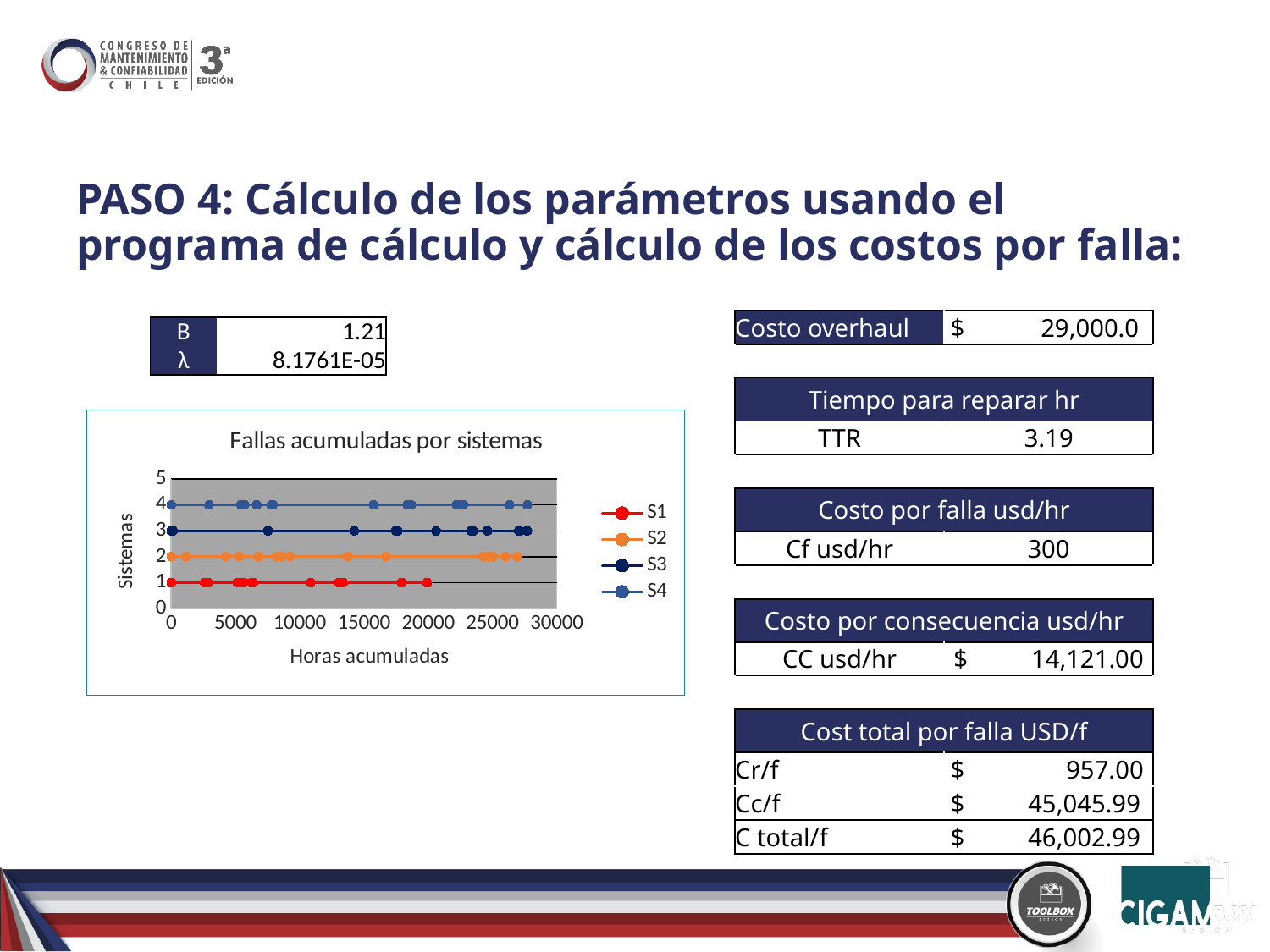
What is the title of the chart on the slide? Fallas acumuladas por sistemas Which series plots at the highest value on the Sistemas axis? S4 Which series lies higher on the Sistemas axis, S2 or S3? S3 What is the difference between the Sistemas value of series S4 and that of series S1? 3 What kind of chart is shown on the slide? line chart What are the series names listed in the chart legend? S1, S2, S3, S4 Which series plots at the lowest value on the Sistemas axis? S1 Do the values of series S2 rise, fall, or stay flat as Horas acumuladas increases? stay flat At which value on the Sistemas axis do the points of series S4 lie? 4 How many series does the legend of the chart list? 4 At which value on the Sistemas axis do the points of series S1 lie? 1 At which value on the Sistemas axis do the points of series S3 lie? 3